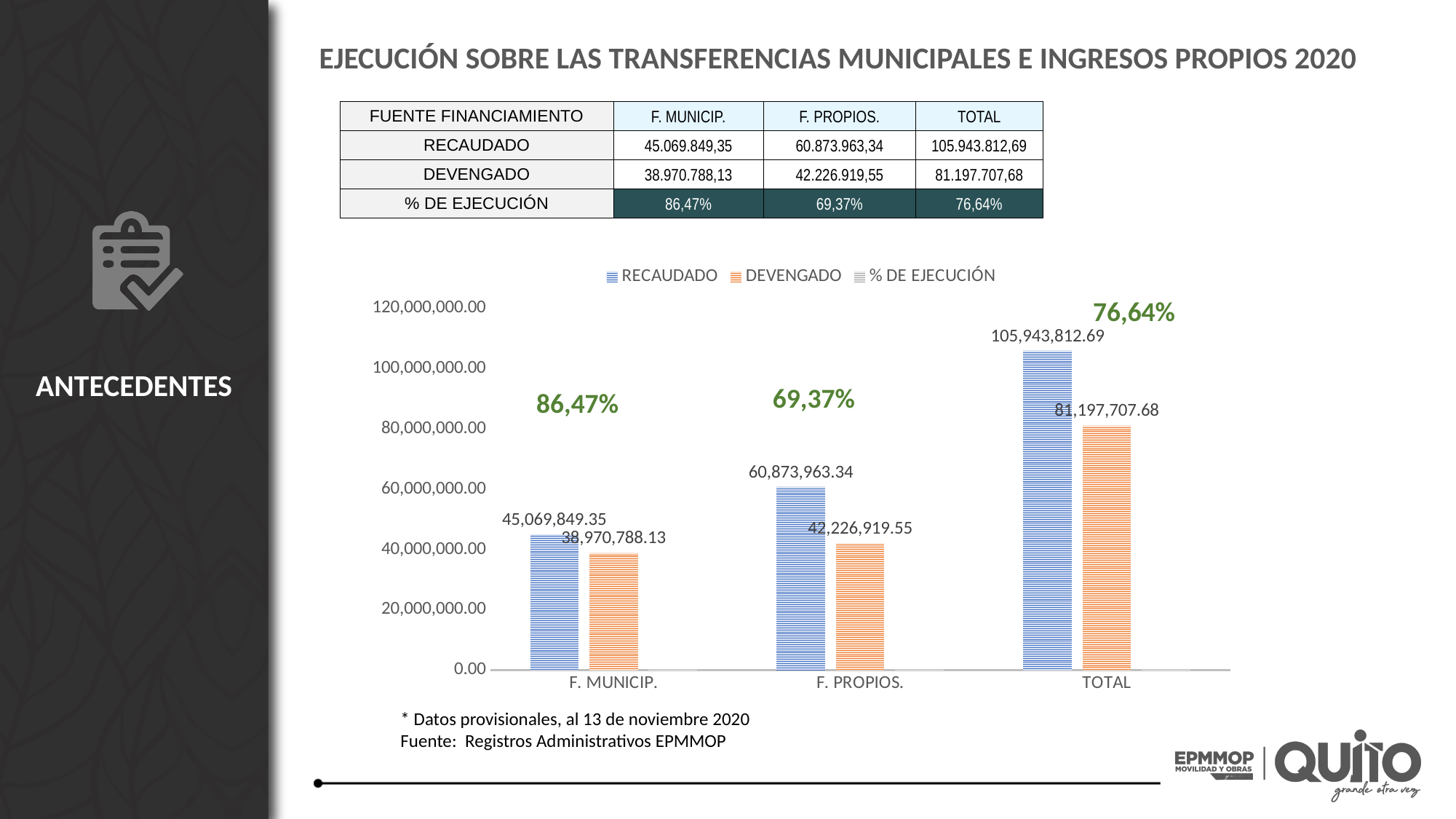
How many categories are shown on the x axis of the chart? 3 How many series does the chart legend list? 3 What is the RECAUDADO value for F. MUNICIP. in the chart? 45,069,849.35 Is the RECAUDADO value for TOTAL greater or less than 100,000,000.00? greater What is the difference between RECAUDADO and DEVENGADO for F. PROPIOS. in the chart? 18,647,043.79 Which category has the lowest DEVENGADO value in the chart? F. MUNICIP. What is the DEVENGADO value for F. PROPIOS. in the chart? 42,226,919.55 What kind of chart is shown on the slide? bar chart What is the % DE EJECUCIÓN shown for TOTAL in the chart? 76,64% Which is larger in the chart: the RECAUDADO value for F. PROPIOS. or the DEVENGADO value for TOTAL? DEVENGADO value for TOTAL Which category has the highest RECAUDADO value in the chart? TOTAL What is the DEVENGADO value for TOTAL in the chart? 81,197,707.68